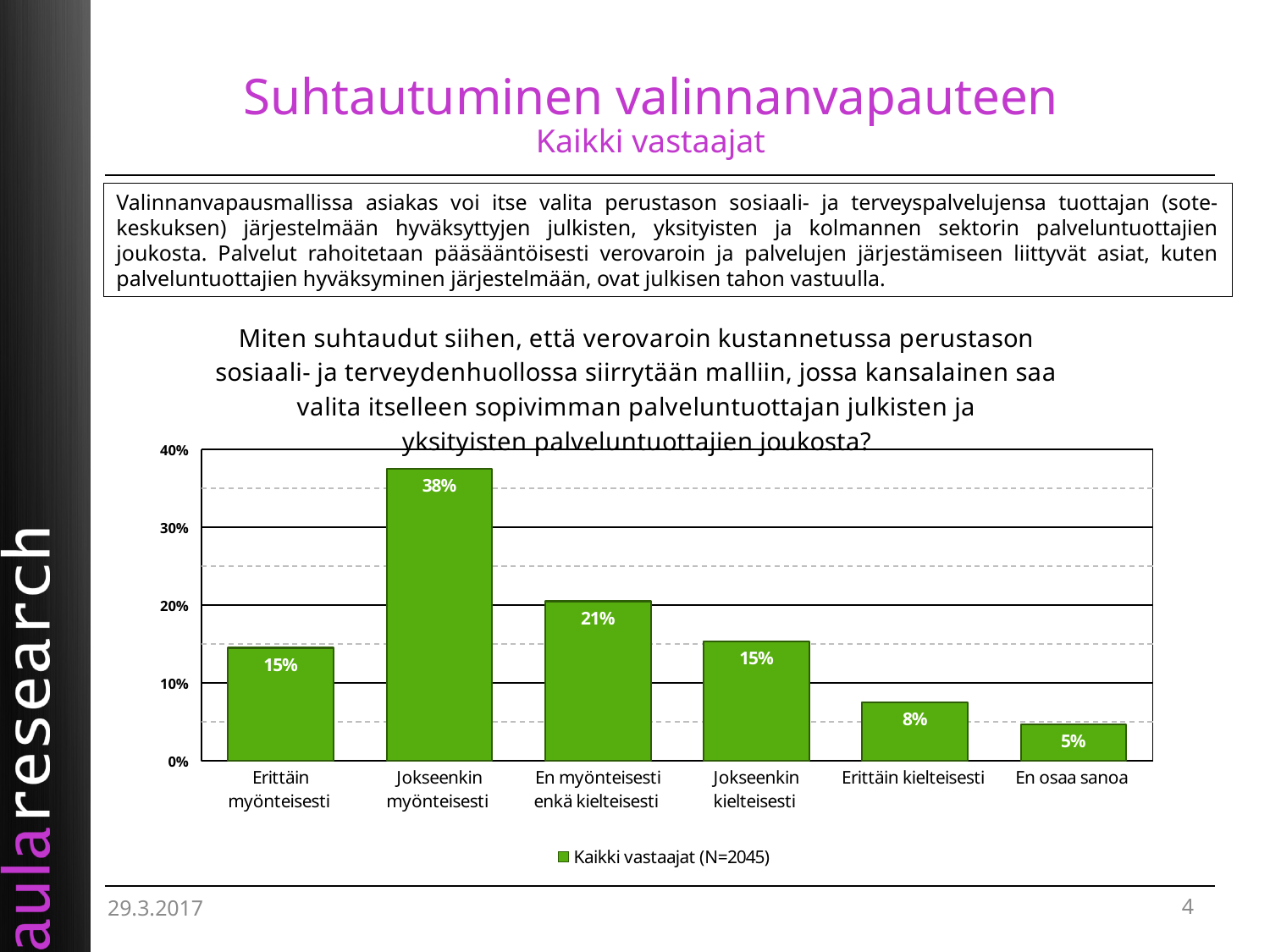
What kind of chart is shown on the slide? bar chart What is the difference between Jokseenkin myönteisesti and En myönteisesti enkä kielteisesti? 17% Which is larger, Erittäin myönteisesti or Erittäin kielteisesti? Erittäin myönteisesti How many categories are shown on the x axis? 6 What is the value for Jokseenkin myönteisesti? 38% Which category has the highest value? Jokseenkin myönteisesti Which category has the lowest value? En osaa sanoa What is the value for En osaa sanoa? 5% What is the legend entry of the chart? Kaikki vastaajat (N=2045) What is the value for En myönteisesti enkä kielteisesti? 21% What is the value for Erittäin kielteisesti? 8% Is the value for Jokseenkin myönteisesti greater or less than 30%? greater